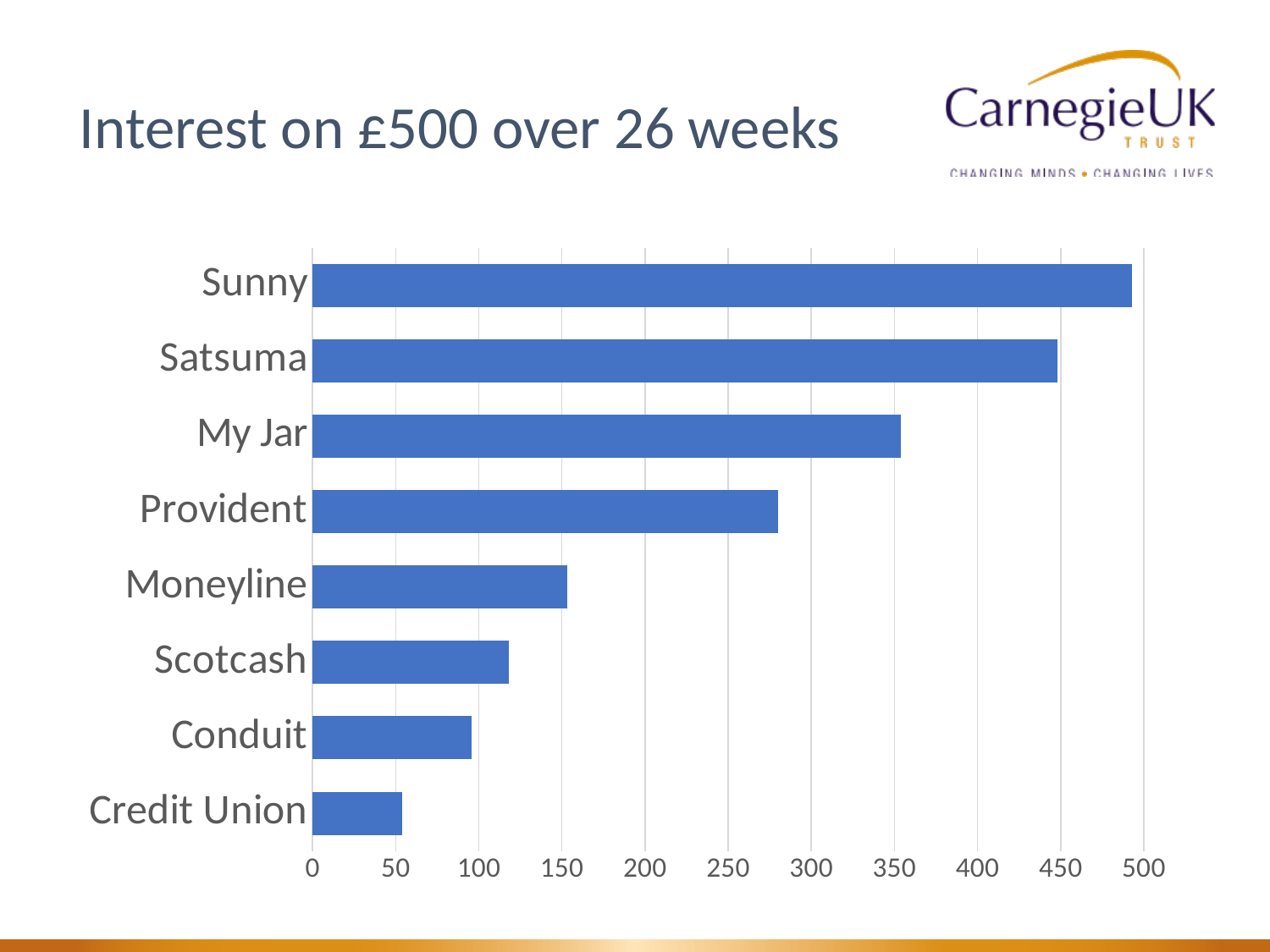
Is the value for Satsuma greater or less than 400? greater Which is larger, the value for Scotcash or the value for Conduit? Scotcash What is the title of the chart? Interest on £500 over 26 weeks Is the value for Sunny greater or less than 450? greater Is the value for Provident greater or less than 250? greater Which lender has the highest interest on £500 over 26 weeks? Sunny What kind of chart is shown on the slide? bar chart Which lender has the lowest interest on £500 over 26 weeks? Credit Union How many lenders are shown on the chart? 8